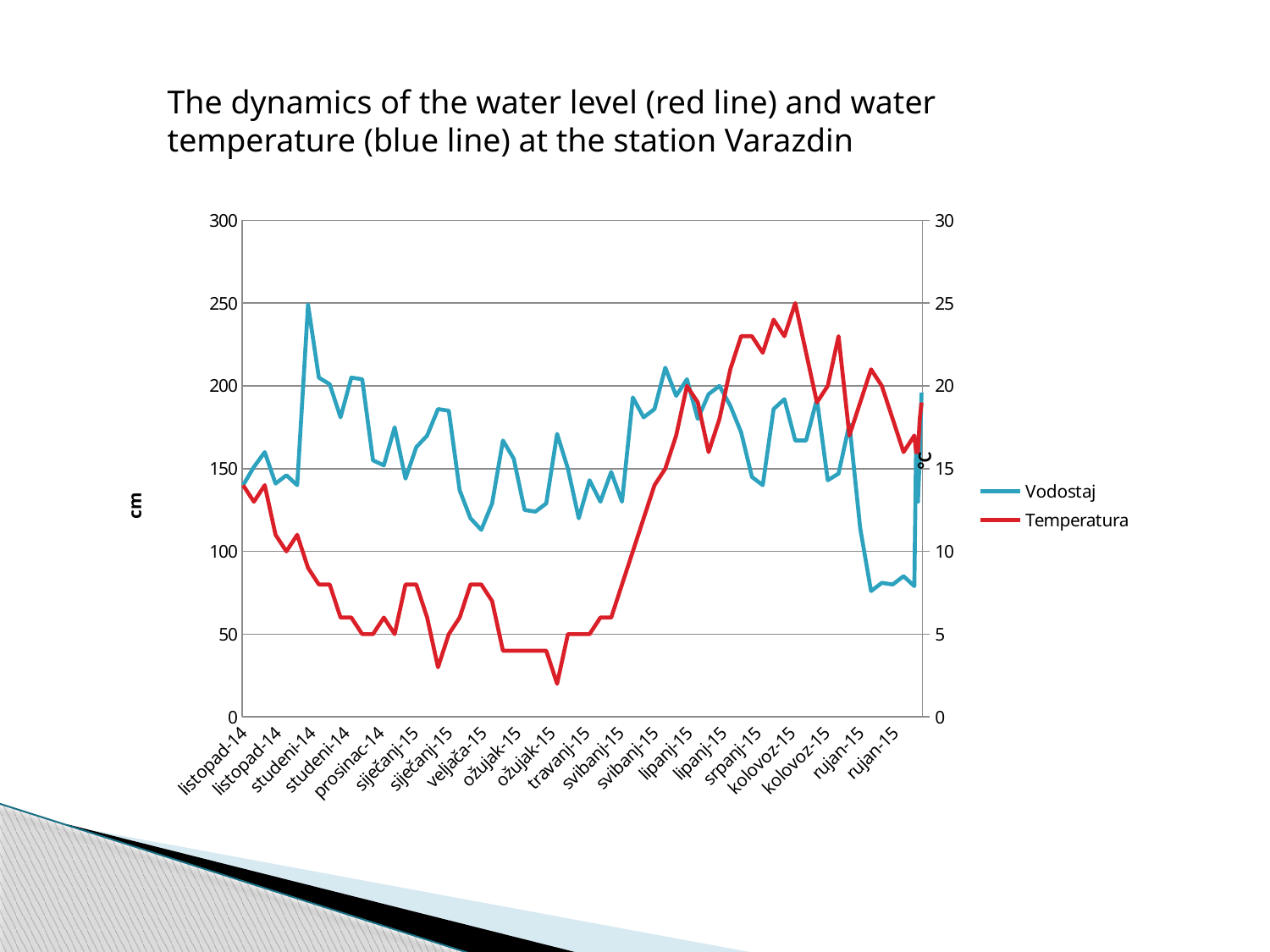
Does the Temperatura (red) line rise or fall between ožujak-15 and kolovoz-15? rise At which month label does the Temperatura (red) line reach its highest value? kolovoz-15 Is the lowest value of the Vodostaj (blue) line greater or less than 100 cm? less At which month label does the Temperatura (red) line reach its lowest value? ožujak-15 What unit is shown on the left vertical axis? cm Is the peak value of the Vodostaj (blue) line greater or less than 200 cm? greater How many series does the legend list? 2 At which month label does the Vodostaj (blue) line reach its highest value? studeni-14 What kind of chart is shown on the slide? line chart What are the two series named in the legend? Vodostaj and Temperatura Is the peak value of the Temperatura (red) line greater or less than 20 °C? greater